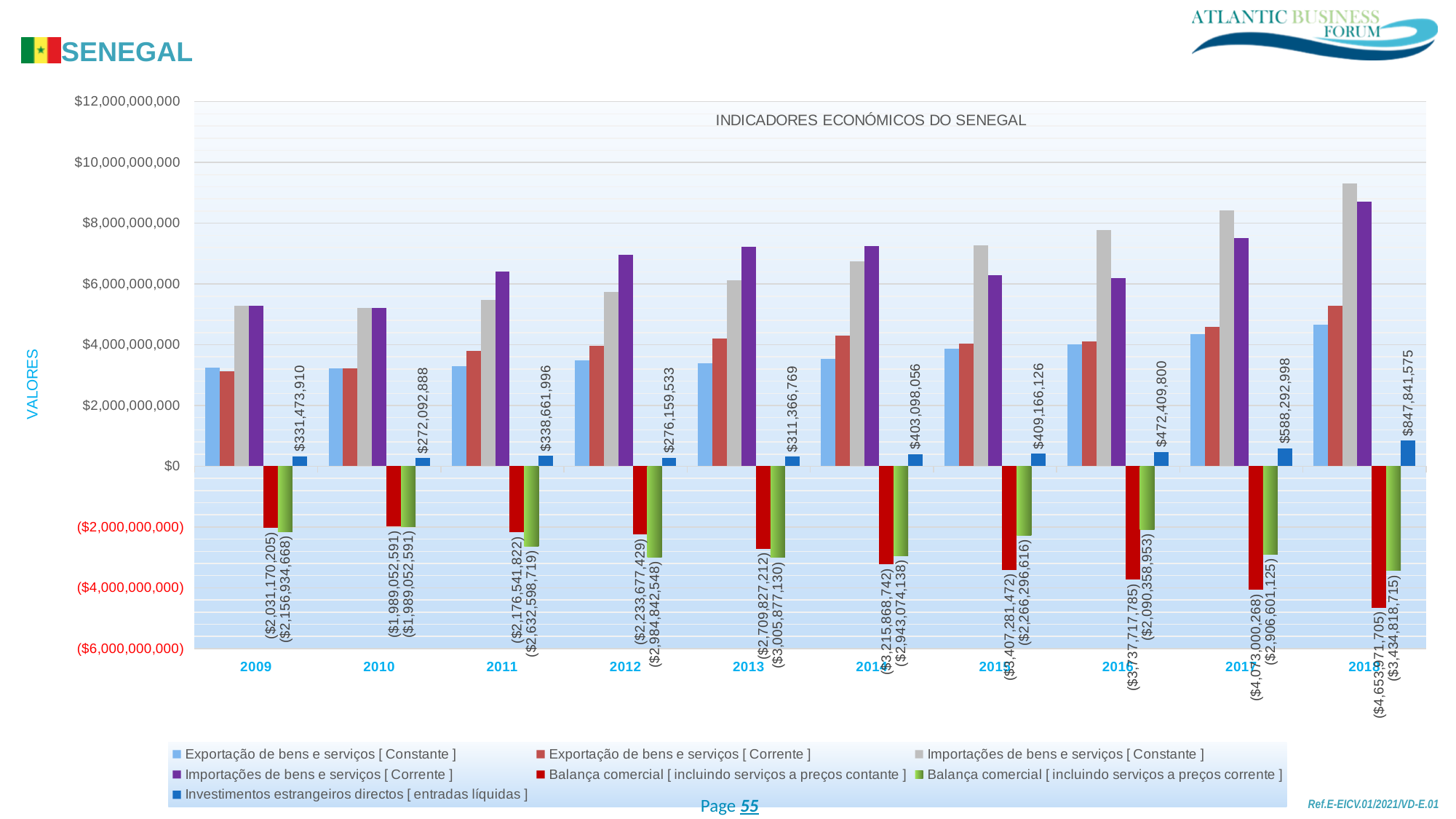
What is the difference between Investimentos estrangeiros directos [ entradas líquidas ] in 2018 and in 2017? $259,548,577 Which year has the larger value for Investimentos estrangeiros directos [ entradas líquidas ], 2014 or 2015? 2015 In which year is Investimentos estrangeiros directos [ entradas líquidas ] highest? 2018 How many years are shown on the x axis of the chart? 10 What is the value of Investimentos estrangeiros directos [ entradas líquidas ] for 2009? $331,473,910 What is the value of Balança comercial [ incluindo serviços a preços corrente ] for 2012? ($2,984,842,548) What is the value of Investimentos estrangeiros directos [ entradas líquidas ] for 2018? $847,841,575 What is the value of Balança comercial [ incluindo serviços a preços contante ] for 2017? ($4,073,000,268) In which year is Investimentos estrangeiros directos [ entradas líquidas ] lowest? 2010 Is the value of Importações de bens e serviços [ Constante ] for 2018 greater or less than $8,000,000,000? greater What kind of chart is shown on the slide? bar chart How many series does the legend list? 7